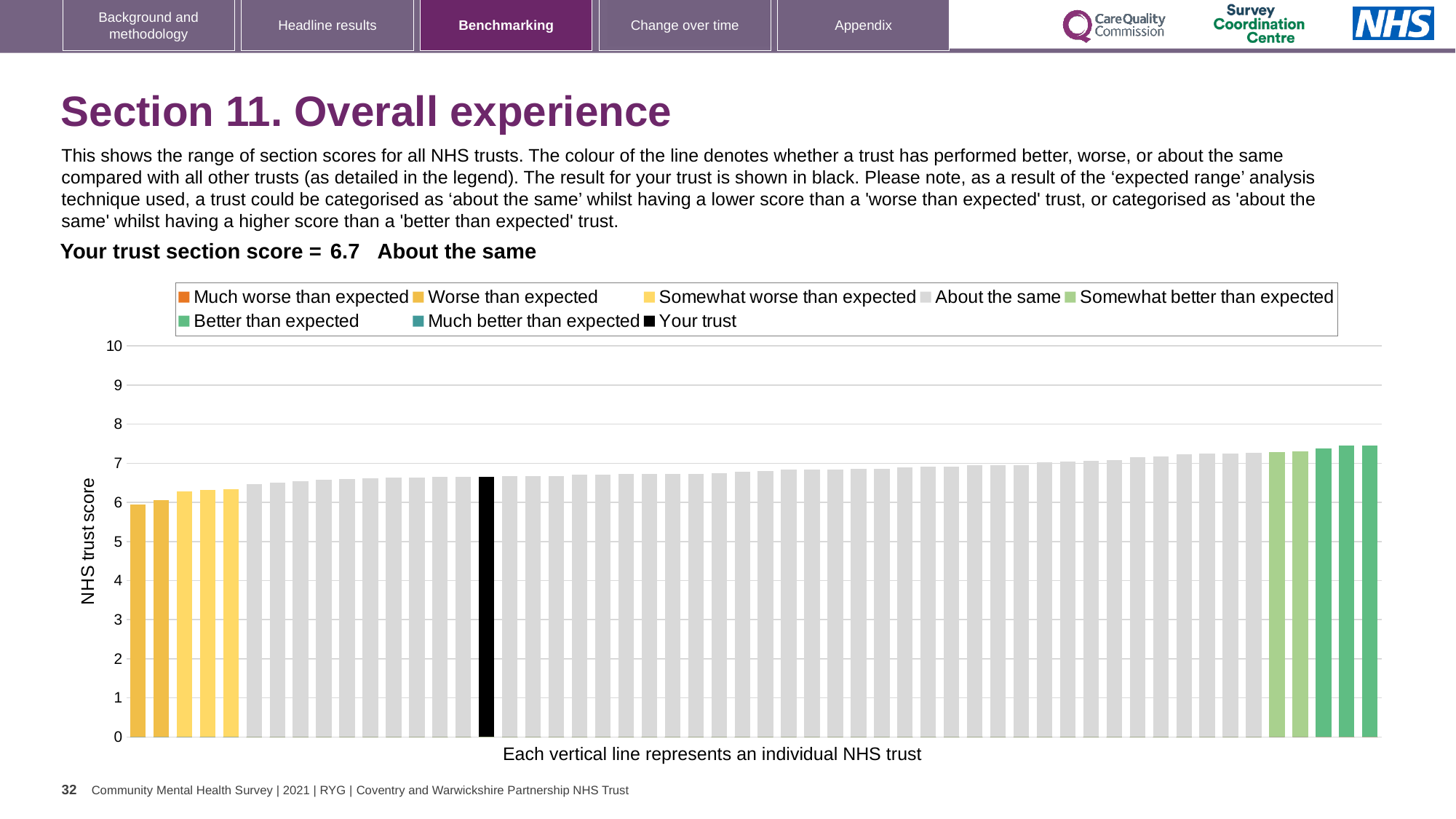
How many entries does the chart legend list? 8 Is the value of the lowest bar greater or less than 5? greater What is the section score for your trust shown on the slide? 6.7 Is the value of the highest bar greater or less than 7? greater What is the label on the y axis of the chart? NHS trust score How many bars are shown in black on the chart? 1 What is the highest value shown on the y axis? 10 What kind of chart is shown on the slide? bar chart How is your trust's score categorised compared with other trusts? About the same Is the value of the highest bar greater or less than 8? less What is the label below the x axis of the chart? Each vertical line represents an individual NHS trust Do the bar values rise or fall from left to right along the x axis? rise